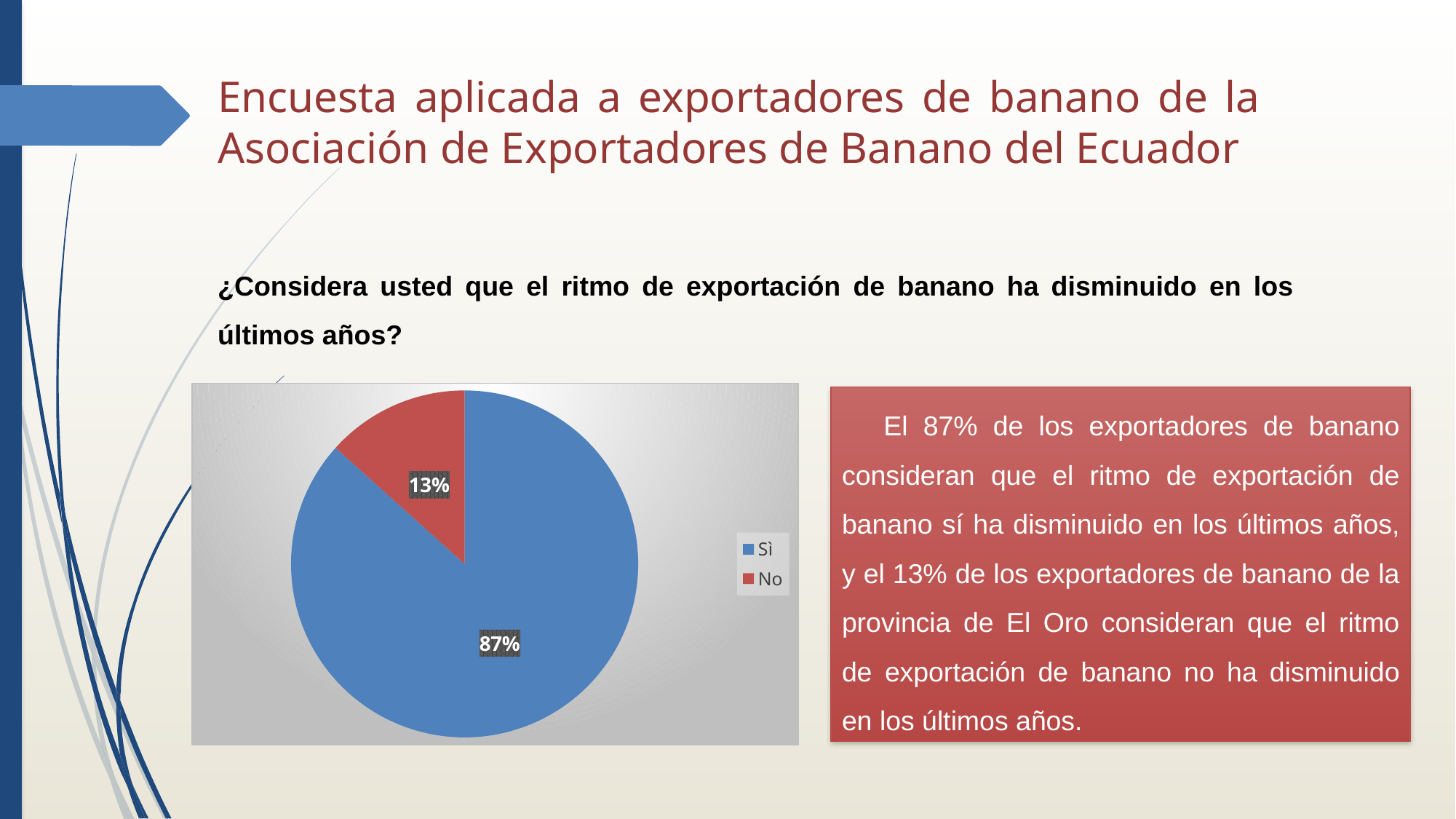
How many slices does the pie chart have? 2 Which category has the largest share of the pie chart? Sì What colour is the "No" slice in the pie chart? red What is the difference in percentage points between the "Sì" and "No" slices? 74 Which slice is larger, "Sì" or "No"? Sì What percentage of the pie chart corresponds to "No"? 13% What percentage of the pie chart corresponds to "Sì"? 87% What kind of chart is shown on the slide? pie chart What colour is the "Sì" slice in the pie chart? blue How many entries does the legend of the pie chart list? 2 Which category has the smallest share of the pie chart? No